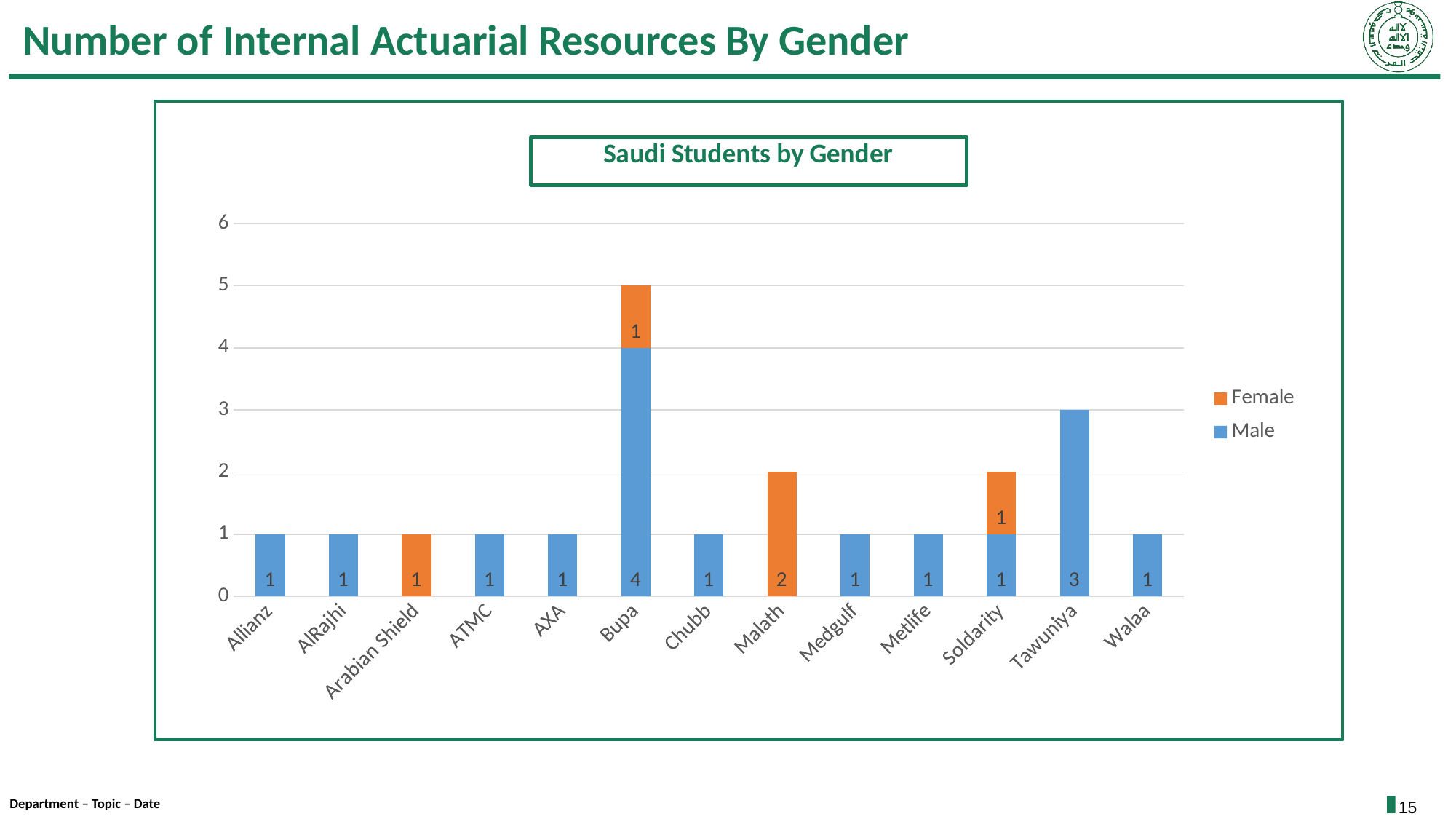
What is the total of the stacked bar for Bupa? 5 What is the Female value for Malath? 2 What is the Male value for Tawuniya? 3 What is the Female value for Soldarity? 1 How many series does the legend list? 2 What is the Male value for Bupa? 4 How many companies are shown on the x axis? 13 Which company has the highest Female value? Malath Which is larger, the Male value for Tawuniya or the Female value for Malath? Male value for Tawuniya What is the total of the stacked bar for Soldarity? 2 Which company has the highest Male value? Bupa What is the difference between the Male value for Bupa and the Male value for Tawuniya? 1